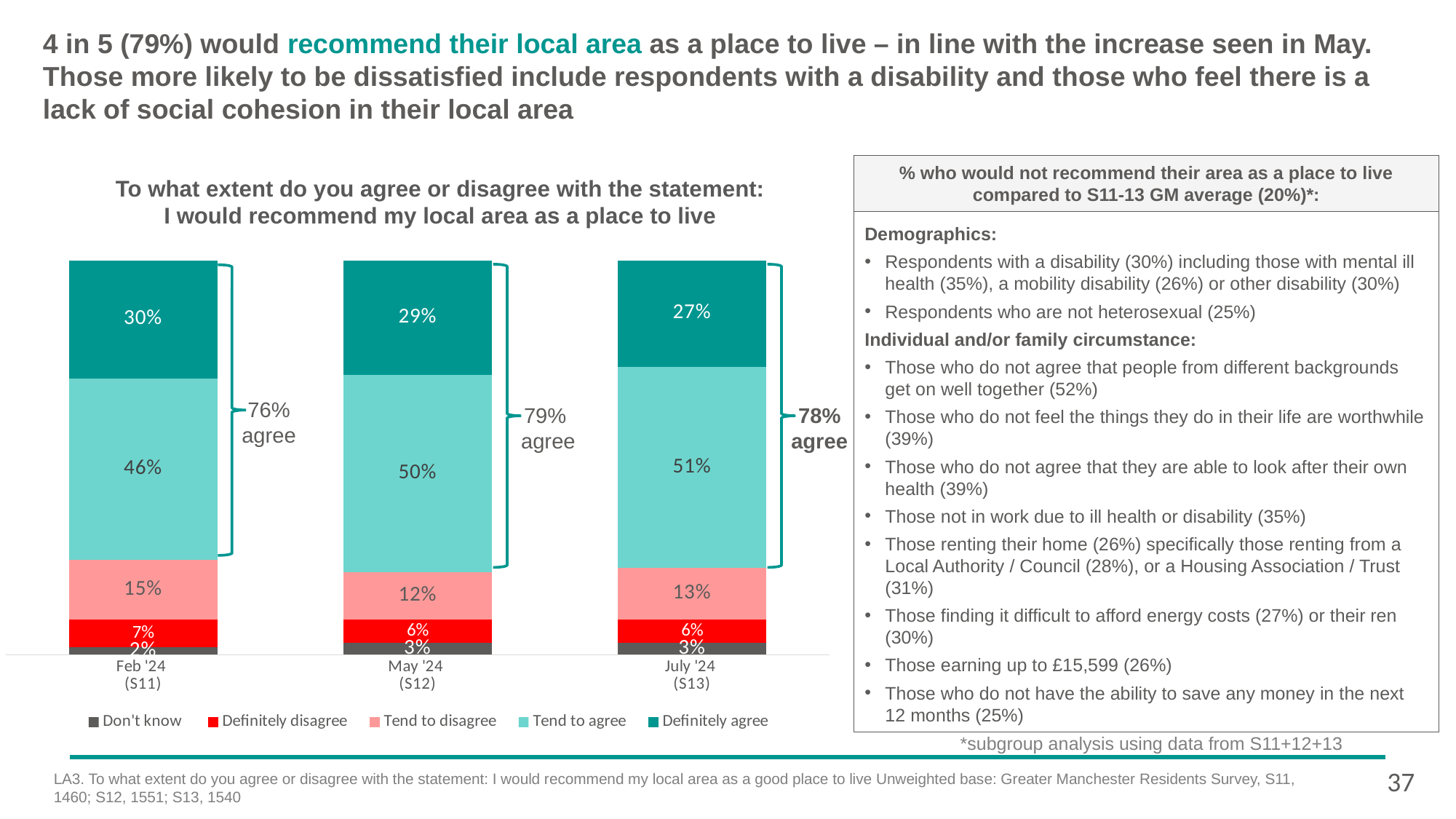
What percentage of respondents said 'Definitely agree' in July '24 (S13)? 27% In which survey wave was the 'Tend to agree' share highest? July '24 (S13) What is the total 'agree' percentage shown for May '24 (S12)? 79% agree How many survey waves are shown on the x axis of the chart? 3 What percentage of respondents said 'Definitely disagree' in Feb '24 (S11)? 7% What kind of chart is used to show the responses? Stacked bar chart In which survey wave was the 'Definitely agree' share lowest? July '24 (S13) What is the difference between the 'Tend to agree' share in May '24 (S12) and Feb '24 (S11)? 4 percentage points How many series does the chart legend list? 5 What percentage of respondents said 'Tend to disagree' in May '24 (S12)? 12% What percentage of respondents said 'Tend to agree' in Feb '24 (S11)? 46% Which is larger: the 'Tend to disagree' share in Feb '24 (S11) or in July '24 (S13)? Feb '24 (S11)